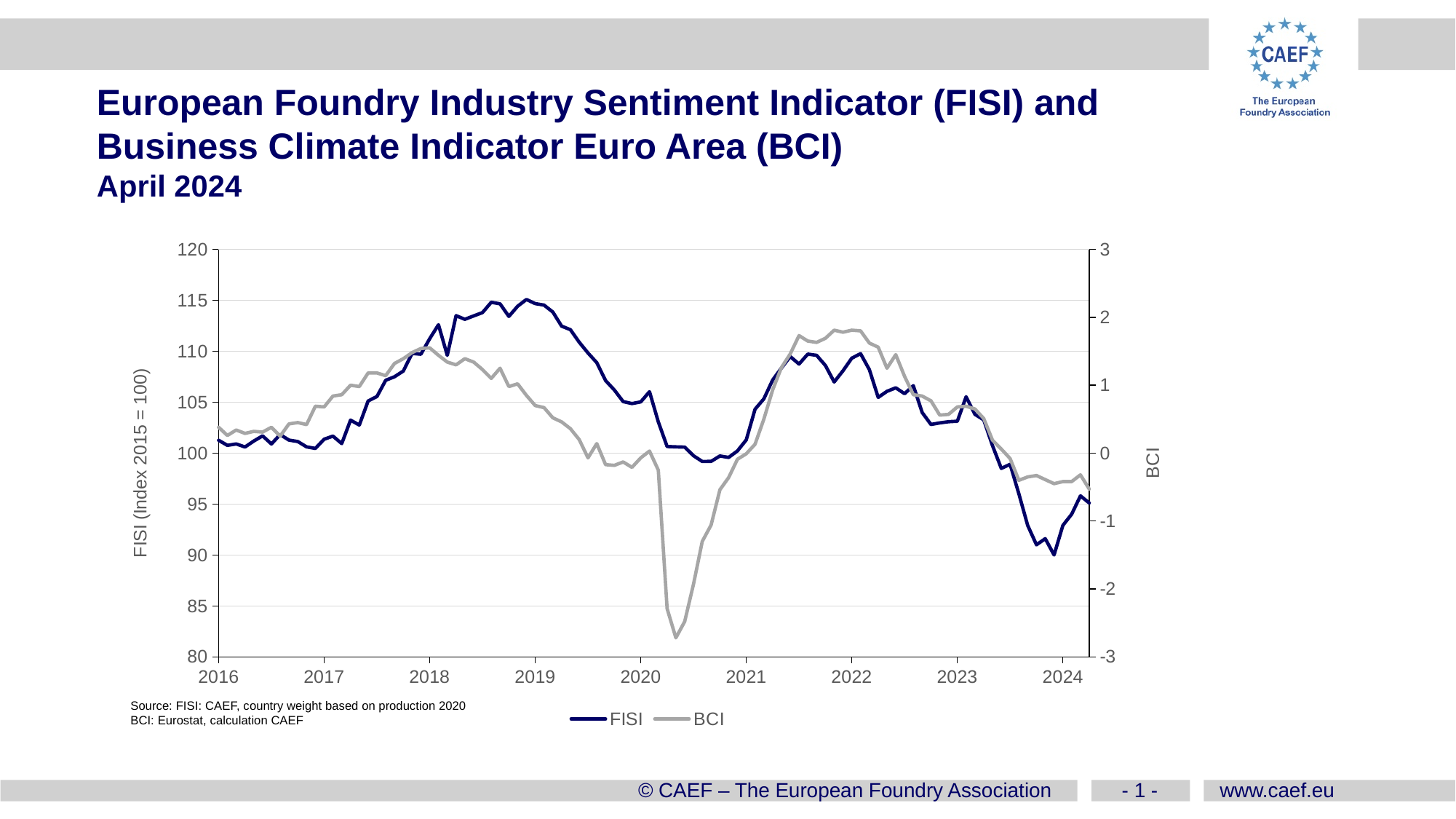
How many series does the legend list? 2 In which year does the BCI line reach its lowest point? 2020 How many year labels are shown on the x axis? 9 Does the FISI line rise or fall between 2017 and 2019? rise Is the lowest BCI value in 2020 greater or less than -2? less Is the FISI value at the start of 2019 greater or less than 110? greater What kind of chart is shown on the slide? line chart Does the BCI line rise or fall between 2022 and 2024? fall Is the BCI value at the start of 2022 greater or less than 1? greater What are the two series named in the legend? FISI and BCI What is the label of the left vertical axis? FISI (Index 2015 = 100)